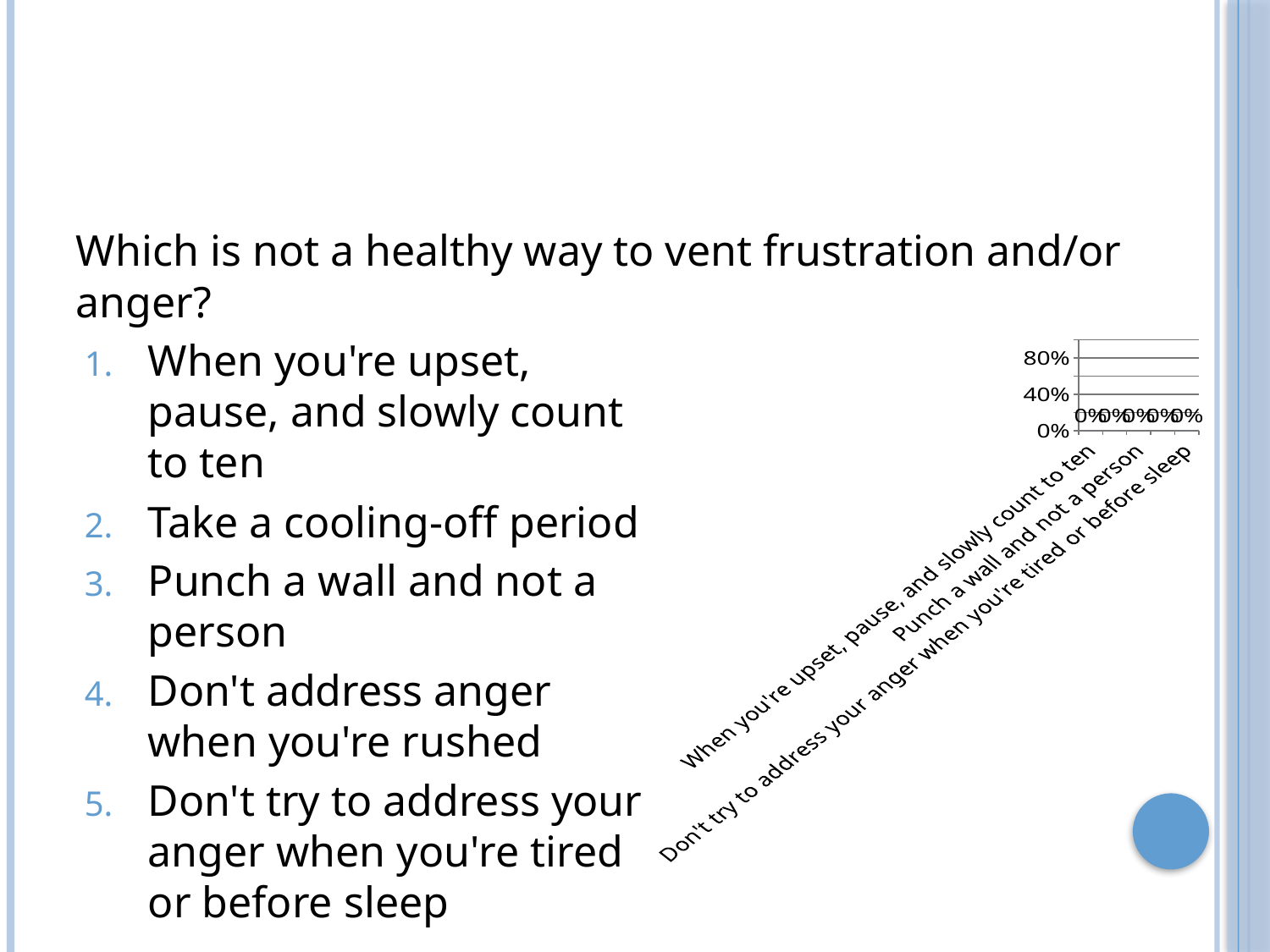
How many data labels are printed on the chart? 5 Do all the data labels on the chart show the same value? Yes, 0% Is the value for "Punch a wall and not a person" greater or less than 40%? less What is the highest tick label shown on the vertical axis? 80% What is the value for "When you're upset, pause, and slowly count to ten"? 0% What kind of chart is shown on the slide? bar chart What is the difference between the values for "When you're upset, pause, and slowly count to ten" and "Punch a wall and not a person"? 0% What is the value for "Punch a wall and not a person"? 0% What is the value for "Don't try to address your anger when you're tired or before sleep"? 0%